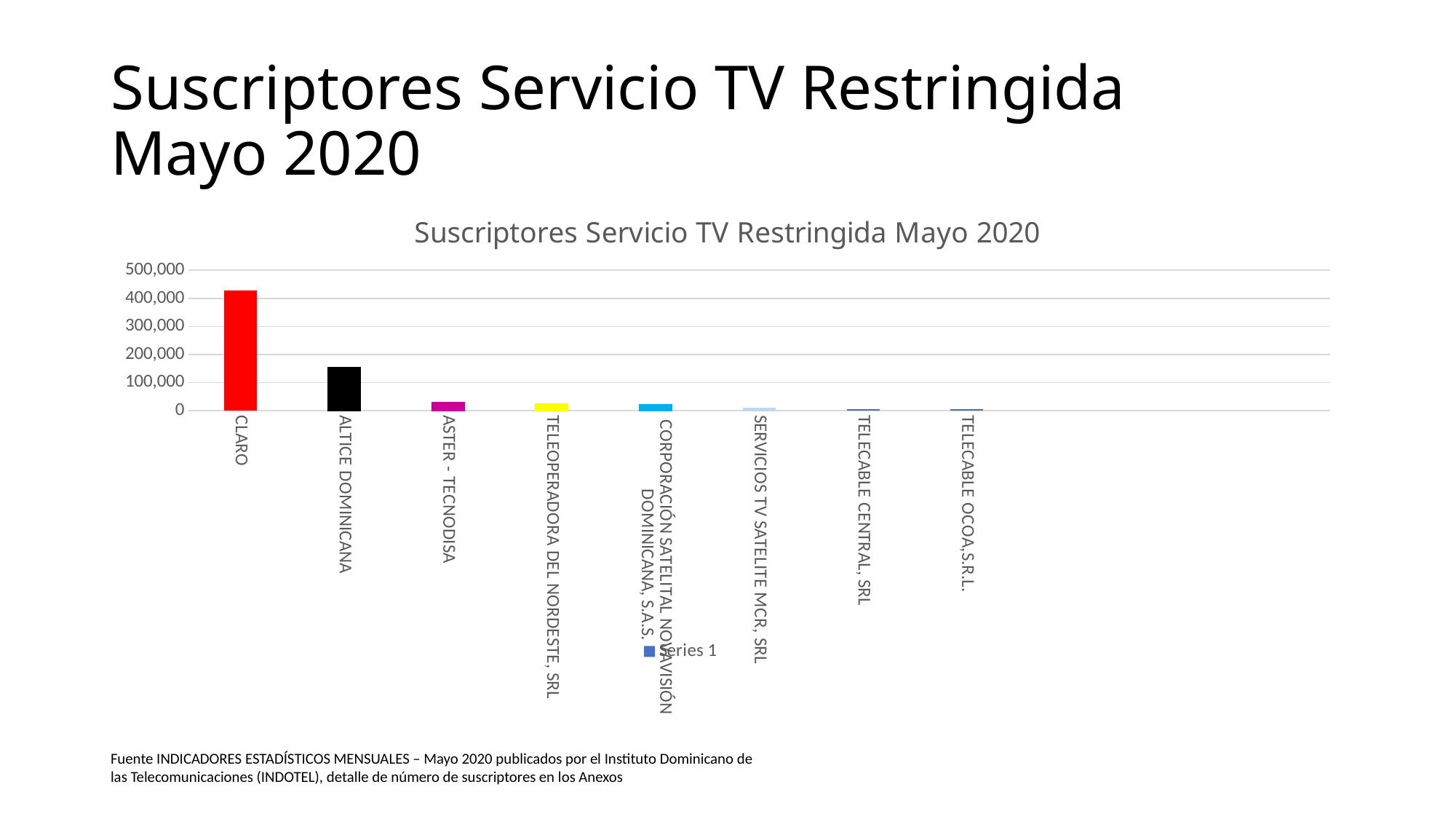
Do the values rise or fall moving from left to right along the x axis? fall How many series does the chart legend list? 1 Which has more subscribers, CLARO or ALTICE DOMINICANA? CLARO What is the title of the chart? Suscriptores Servicio TV Restringida Mayo 2020 How many companies (categories) are shown on the x axis of the chart? 8 Is the value for ALTICE DOMINICANA greater or less than 100,000? greater Which company has the highest number of subscribers in the chart? CLARO What kind of chart is shown on the slide? bar chart Is the value for ASTER - TECNODISA greater or less than 100,000? less Is the value for CLARO greater or less than 400,000? greater What colour is the bar for CLARO? red